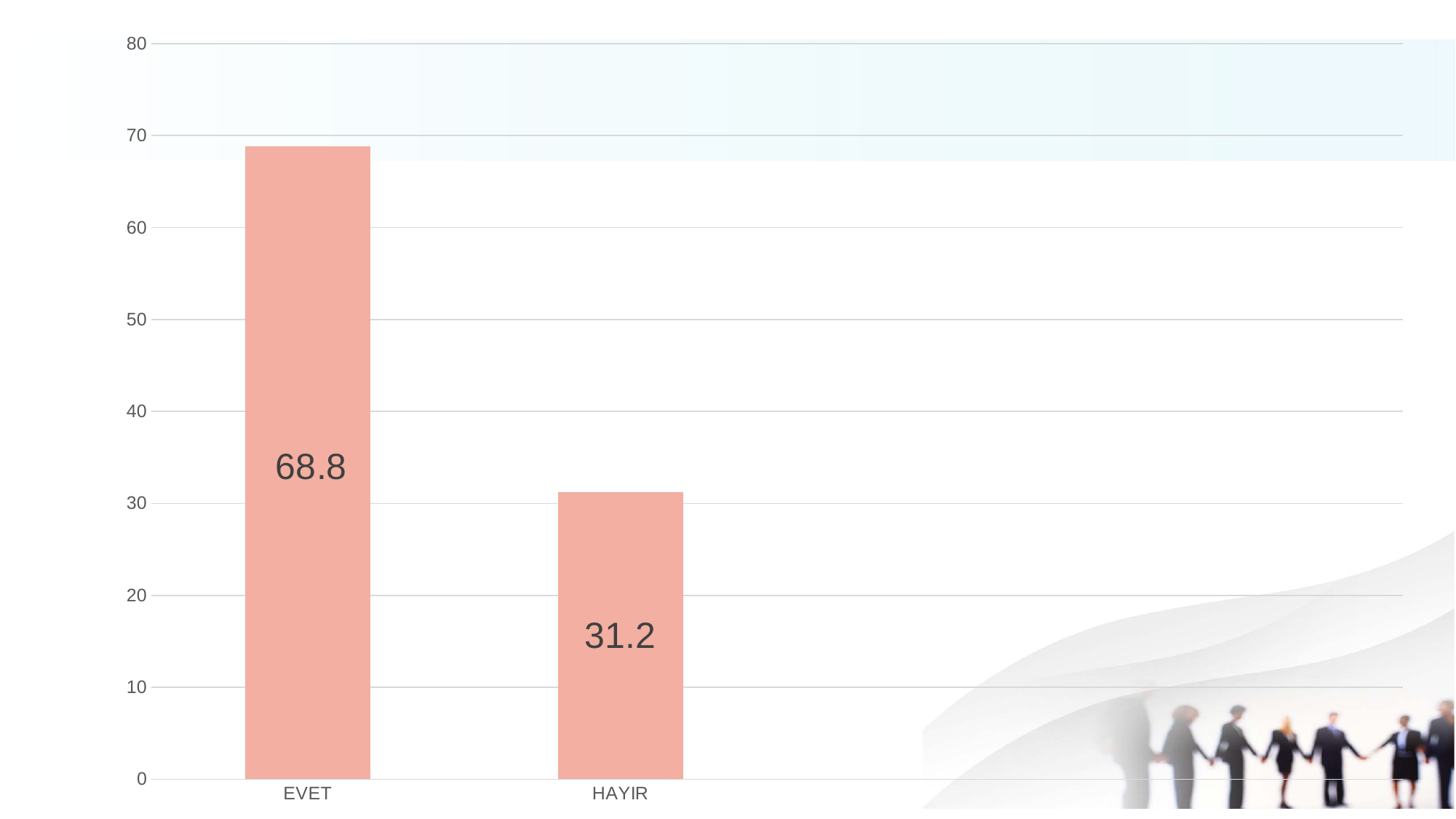
What kind of chart is shown on the slide? bar chart Which category has the lowest value? HAYIR Which category has the highest value? EVET What is the total of the values for EVET and HAYIR? 100 What is the highest value shown on the vertical axis? 80 Which is larger, the value for EVET or the value for HAYIR? EVET How many categories are shown on the x axis? 2 Is the value for HAYIR greater or less than 40? less What is the difference between the values for EVET and HAYIR? 37.6 Is the value for EVET greater or less than 60? greater What is the value for EVET? 68.8 What is the value for HAYIR? 31.2